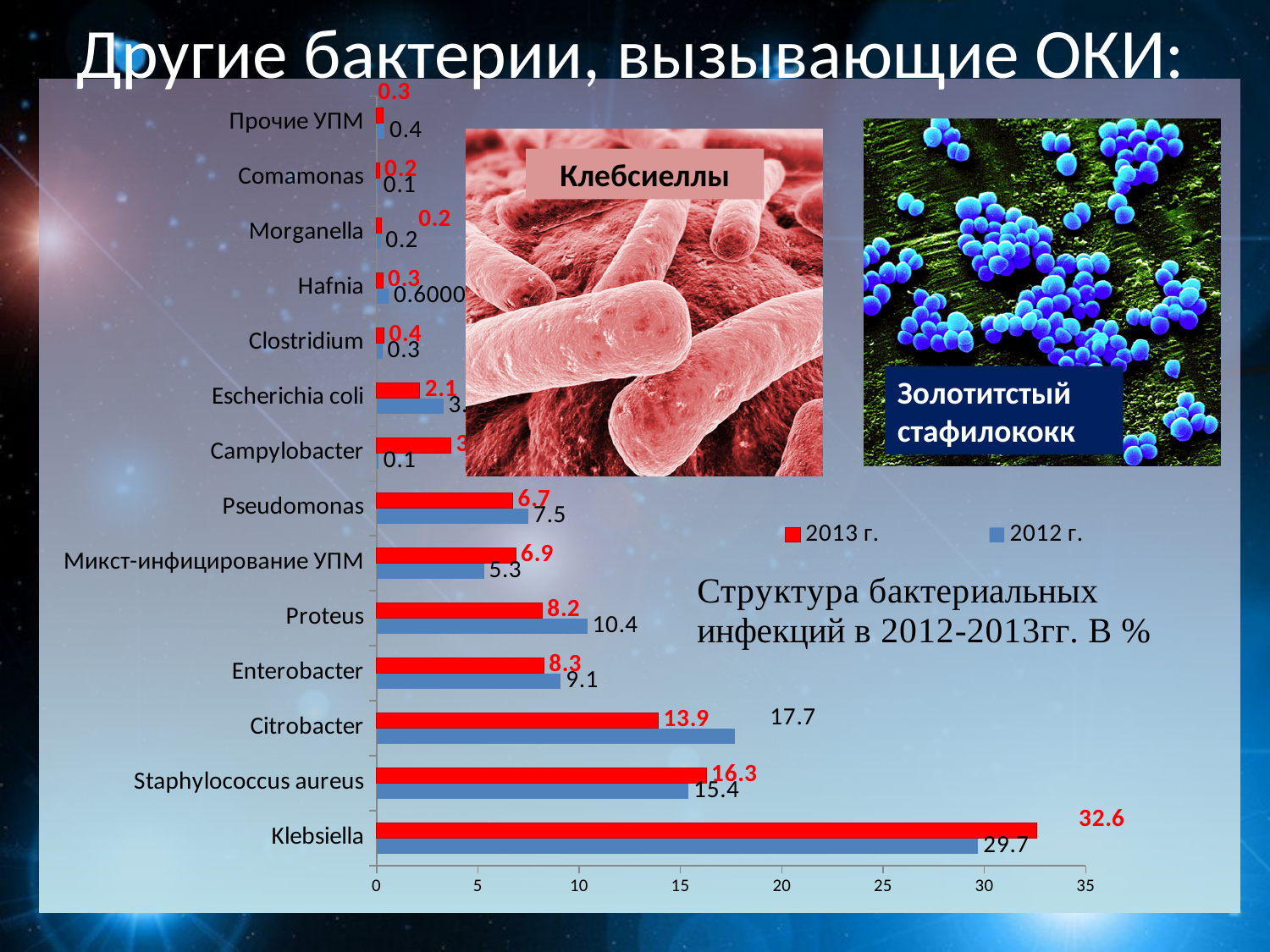
Which category has the highest 2013 г. value? Klebsiella What is the 2012 г. value for Proteus? 10.4 How many bacteria categories are plotted on the chart? 14 Is the 2013 г. value for Staphylococcus aureus greater or less than 15? greater For Citrobacter, which series has the larger value, 2013 г. or 2012 г.? 2012 г. How many series does the chart legend list? 2 Which colour represents the 2013 г. series in the chart? red What is the difference between the 2013 г. and 2012 г. values for Klebsiella? 2.9 What is the 2012 г. value for Citrobacter? 17.7 What type of chart is shown on the slide? bar chart What is the 2013 г. value for Klebsiella? 32.6 What is the 2013 г. value for Микст-инфицирование УПМ? 6.9